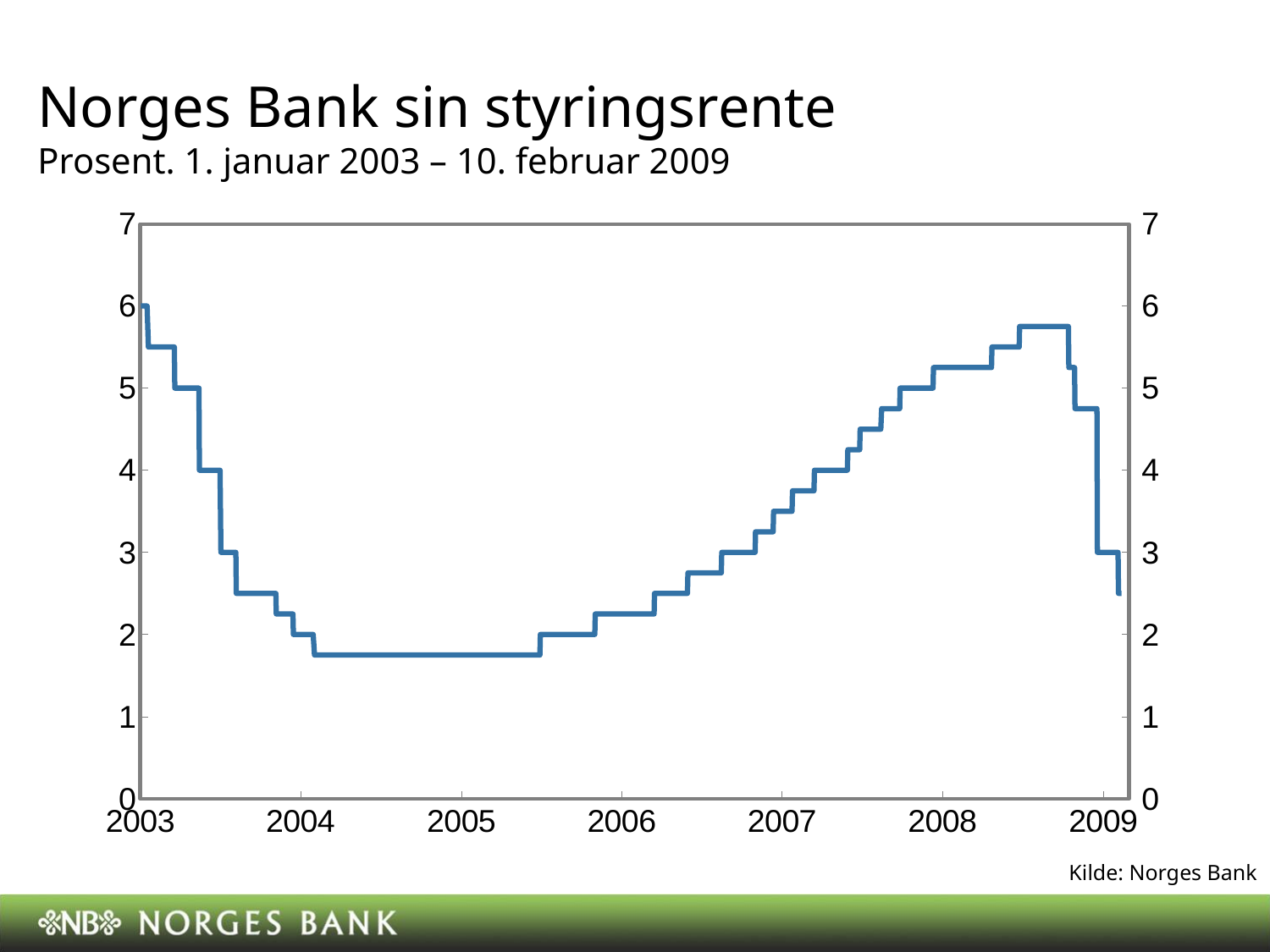
What is the title of the chart? Norges Bank sin styringsrente What kind of chart is shown on the slide? line chart Does the policy rate rise or fall between the start of 2003 and the start of 2004? fall According to the source note, where does the chart's data come from? Norges Bank Is the policy rate at the start of 2003 greater or less than 5? greater Which is higher, the policy rate at the start of 2005 or at the start of 2007? start of 2007 How many year labels are shown on the x axis? 7 Is the policy rate at the start of 2005 greater or less than 2? less Is the policy rate at the end of the series in February 2009 greater or less than 3? less Does the policy rate rise or fall between the start of 2006 and the start of 2008? rise In which year does the policy rate reach its highest level on the chart? 2008